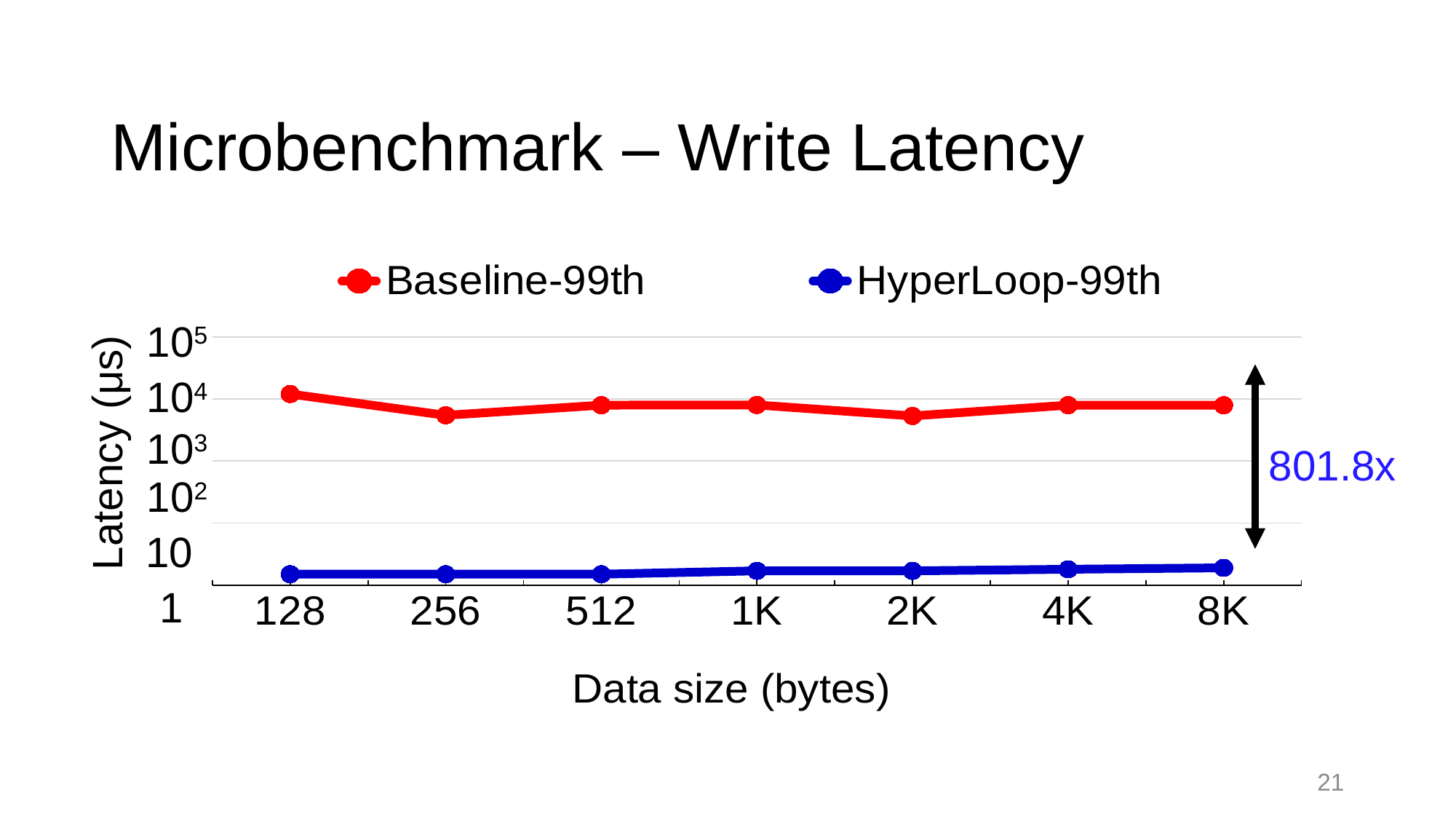
Is the Baseline-99th latency at 2K bytes greater or less than 10^3 µs? greater Which series has the higher latency at 1K bytes, Baseline-99th or HyperLoop-99th? Baseline-99th At which data size is the Baseline-99th latency highest? 128 Is the Baseline-99th latency at 256 bytes greater or less than 10^4 µs? less How many series does the legend list? 2 How many data sizes are plotted along the x axis? 7 What is the label of the y axis? Latency (µs) What kind of chart is shown on the slide? line chart Which series has the lower latency at 8K bytes? HyperLoop-99th Does the HyperLoop-99th latency rise or fall as data size increases from 128 to 8K bytes? rise What speedup factor is annotated between the two lines on the chart? 801.8x